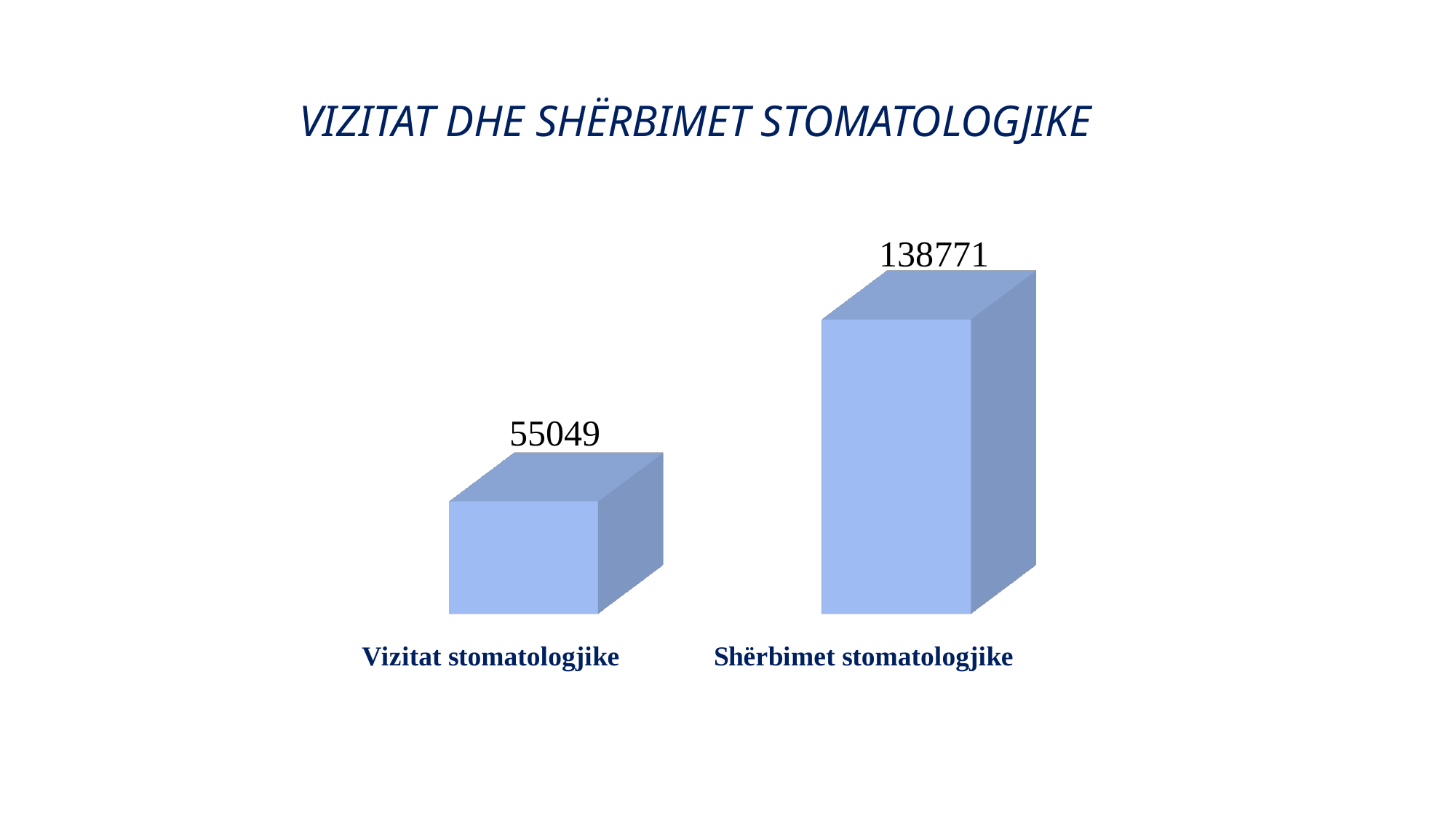
What kind of chart is shown on the slide? Bar chart What is the value for Shërbimet stomatologjike? 138771 Which category has the highest value? Shërbimet stomatologjike What is the value for Vizitat stomatologjike? 55049 How many categories are shown in the chart? 2 Which is larger, the value for Vizitat stomatologjike or the value for Shërbimet stomatologjike? Shërbimet stomatologjike Which category has the lowest value? Vizitat stomatologjike What is the difference between the values for Shërbimet stomatologjike and Vizitat stomatologjike? 83722 What is the title of the slide? VIZITAT DHE SHËRBIMET STOMATOLOGJIKE What is the total of the two values shown in the chart? 193820 What colour are the bars in the chart? Light blue